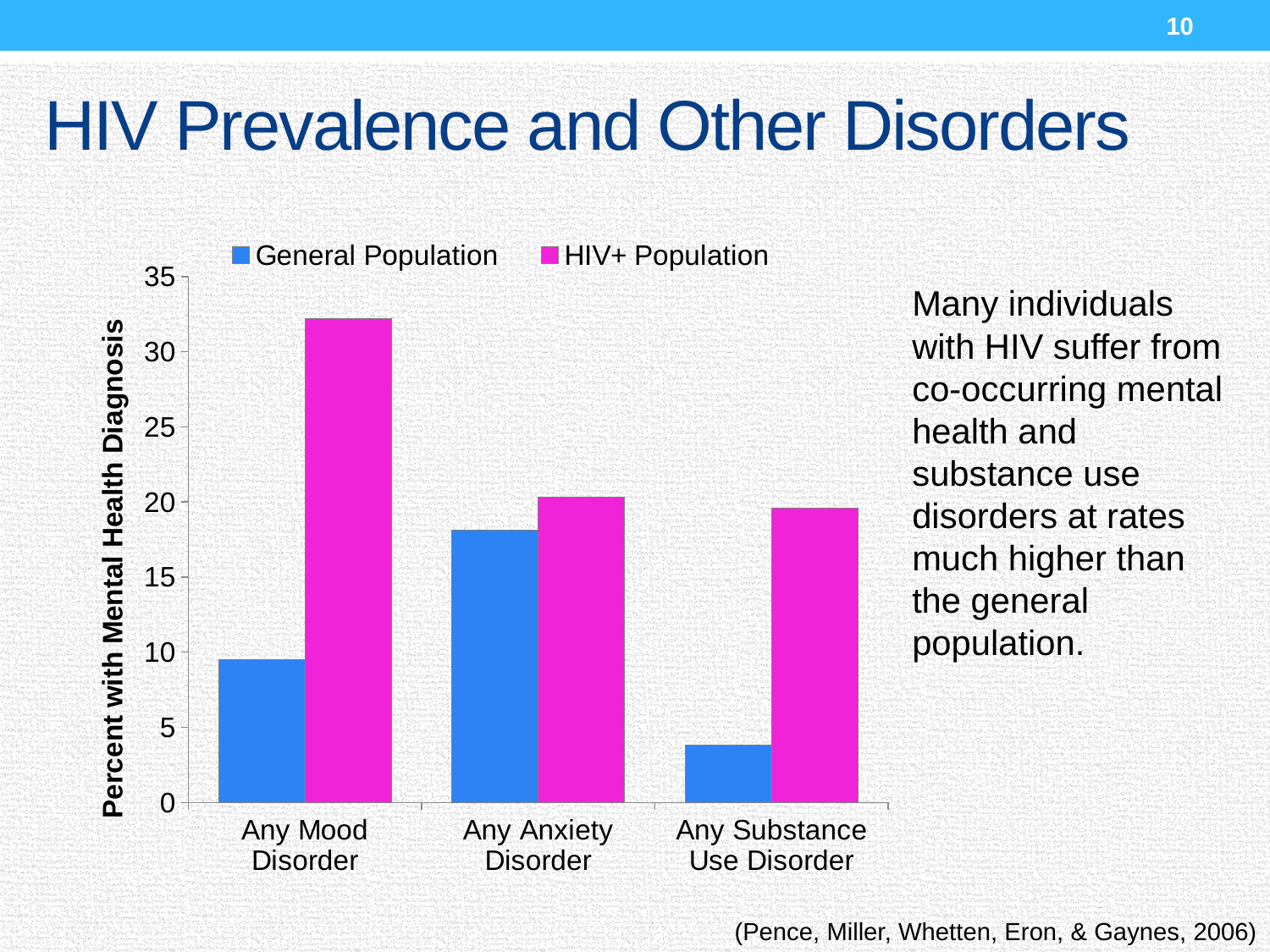
Is the HIV+ Population value for Any Substance Use Disorder greater or less than 15? greater Is the HIV+ Population value for Any Mood Disorder greater or less than 30? greater How many disorder categories are shown on the x axis? 3 Is the General Population value for Any Substance Use Disorder greater or less than 5? less Which category has the lowest value for the General Population? Any Substance Use Disorder Which category has the highest value for the General Population? Any Anxiety Disorder Which category has the highest value for the HIV+ Population? Any Mood Disorder For Any Substance Use Disorder, which is larger: the General Population value or the HIV+ Population value? HIV+ Population What is the label of the vertical axis? Percent with Mental Health Diagnosis What kind of chart is shown on the slide? bar chart How many series does the legend list? 2